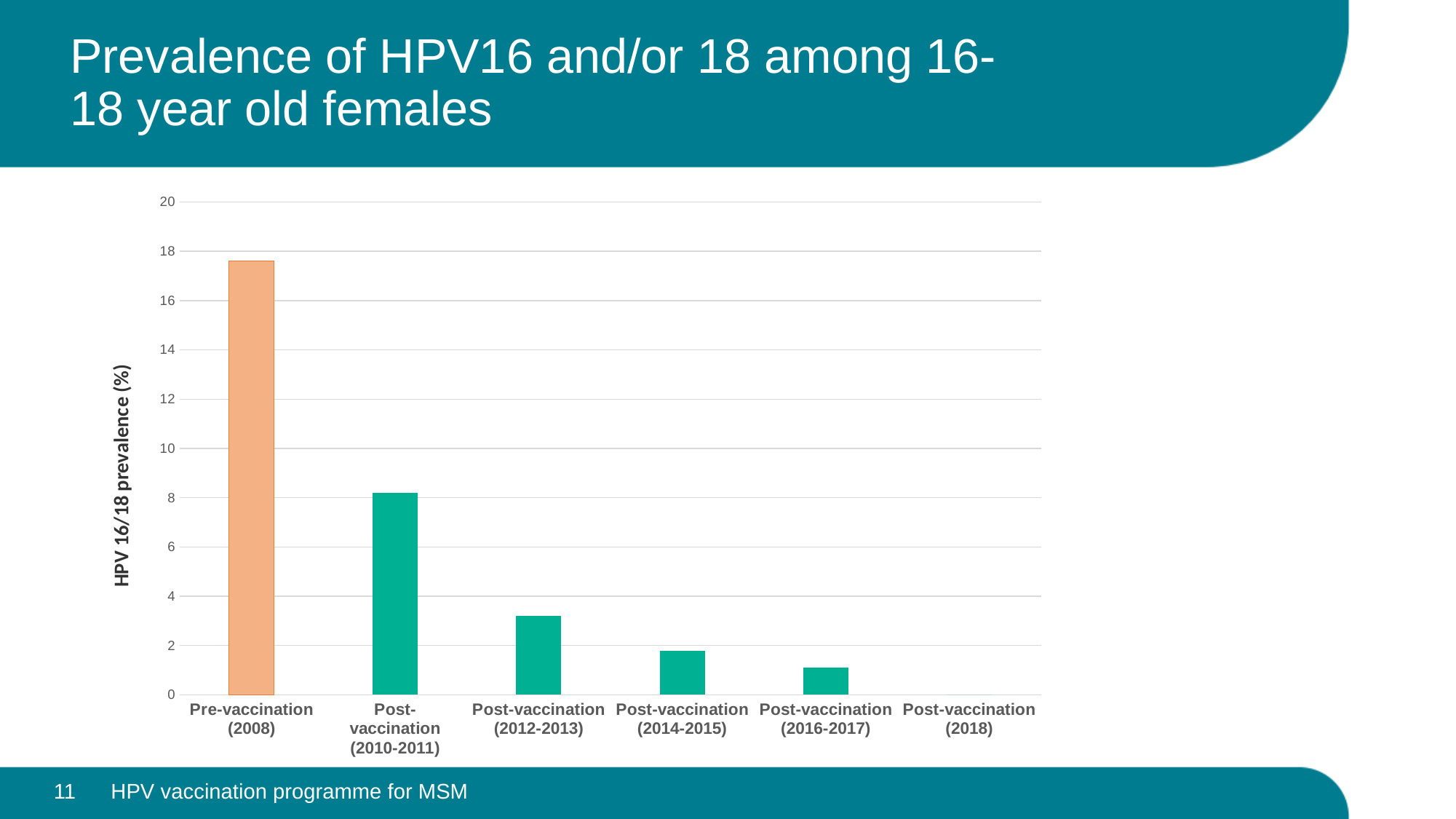
What colour is the Pre-vaccination (2008) bar? orange Is the value for Pre-vaccination (2008) greater or less than 16? greater Is the value for Post-vaccination (2012-2013) greater or less than 4? less What is the title of the y axis? HPV 16/18 prevalence (%) Which category has the highest HPV 16/18 prevalence? Pre-vaccination (2008) Which is larger, the value for Post-vaccination (2010-2011) or Post-vaccination (2012-2013)? Post-vaccination (2010-2011) Do the values rise or fall moving from left to right along the x axis? fall Is the value for Post-vaccination (2016-2017) greater or less than 2? less How many categories are shown on the x axis of the chart? 6 Which category has the lowest HPV 16/18 prevalence? Post-vaccination (2018) What kind of chart is shown on the slide? bar chart